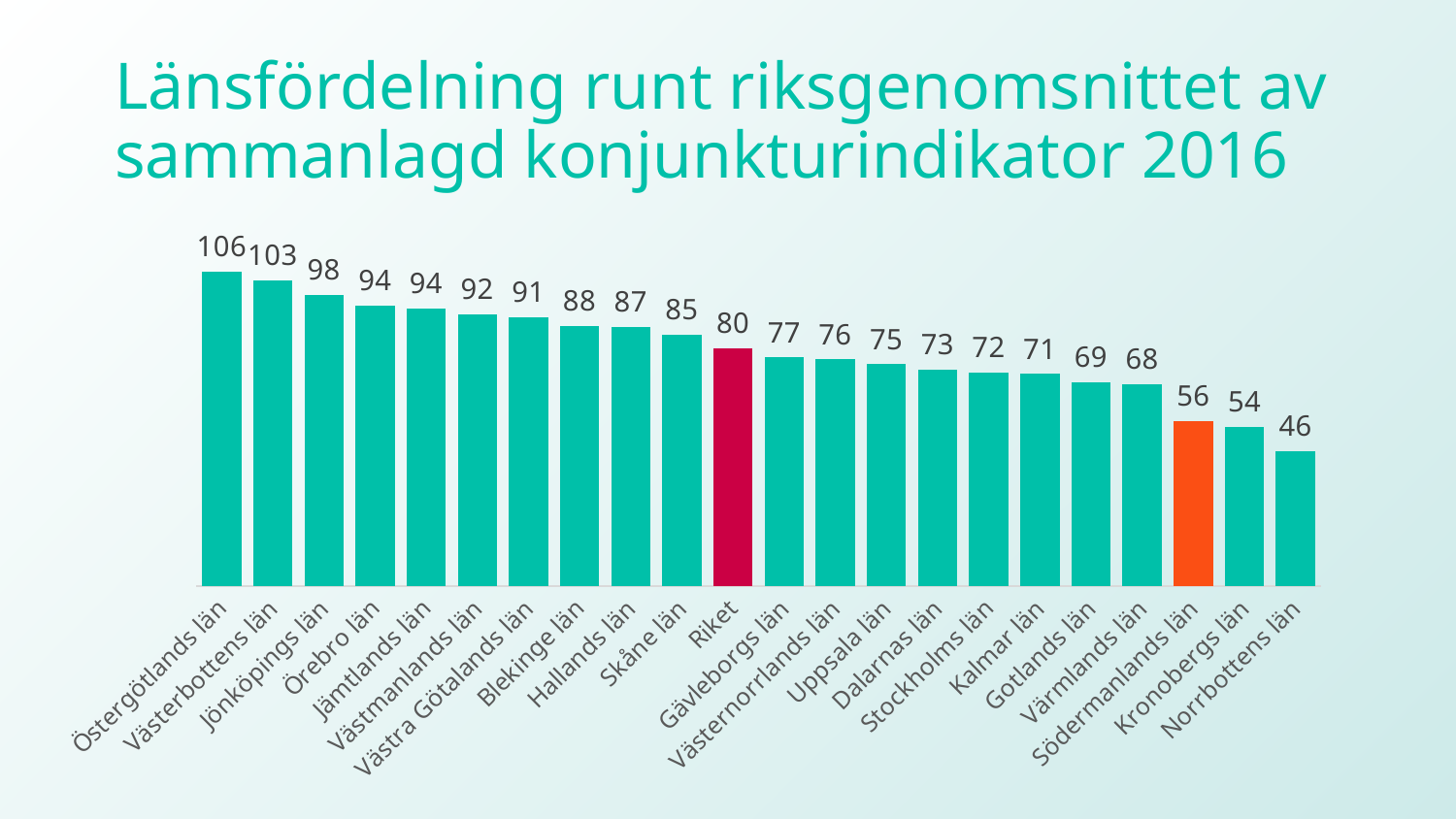
What is the value for Riket? 80 What is the difference between the values for Skåne län and Riket? 5 What kind of chart is shown on the slide? Bar chart Do the values rise or fall from left to right along the x axis? Fall Which bar is coloured orange? Södermanlands län What is the value for Stockholms län? 72 What is the difference between the values for Östergötlands län and Norrbottens län? 60 How many bars are shown in the chart? 22 Which category has the lowest value? Norrbottens län Which category has the highest value? Östergötlands län What is the value for Södermanlands län? 56 Which is larger, the value for Uppsala län or the value for Gotlands län? Uppsala län